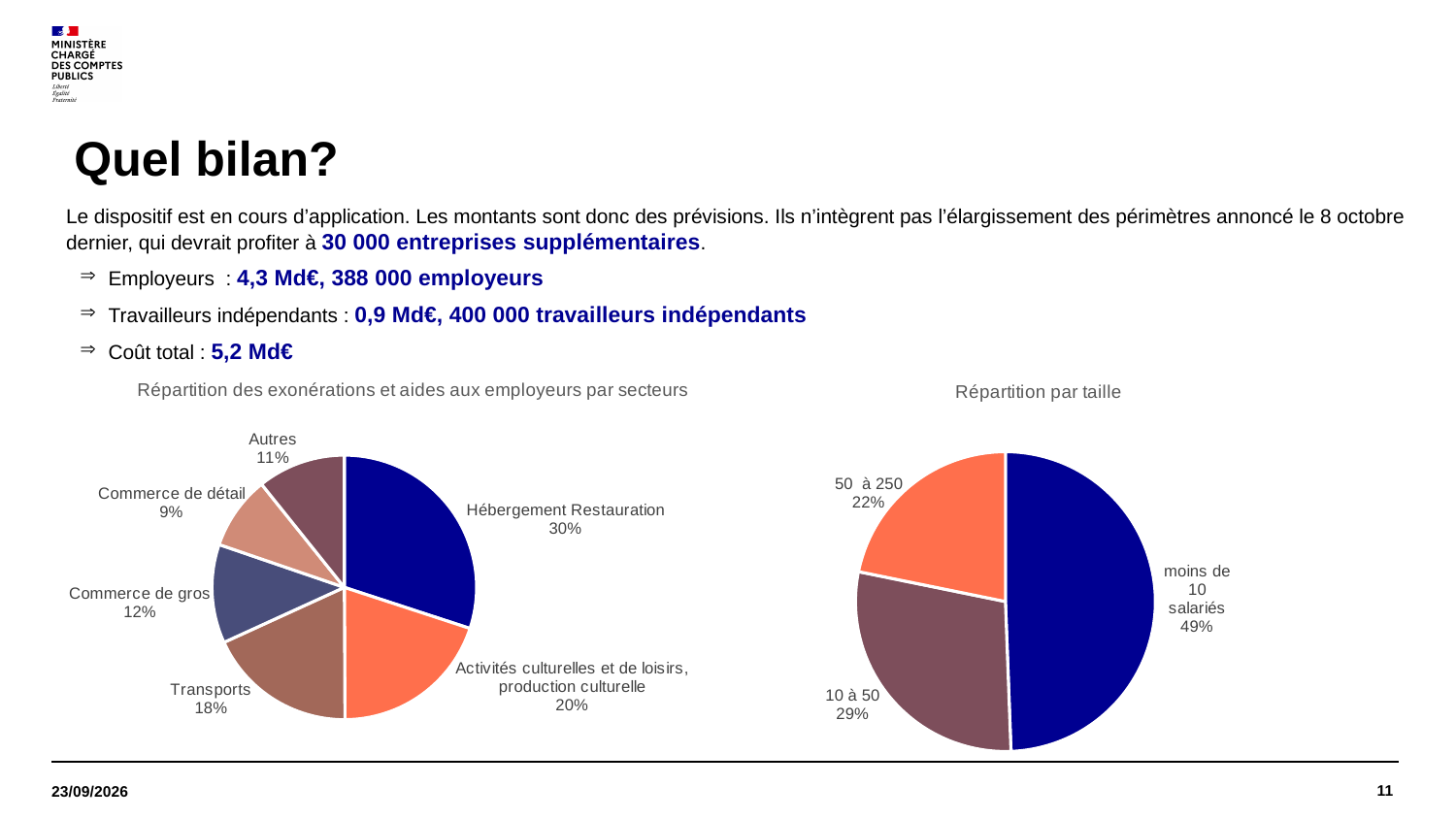
In the chart titled "Répartition des exonérations et aides aux employeurs par secteurs", which sector has the smallest share? Commerce de détail In the chart titled "Répartition par taille", what share do companies with moins de 10 salariés have? 49% In the chart titled "Répartition par taille", what is the difference between 10 à 50 and 50 à 250? 7% In the chart titled "Répartition des exonérations et aides aux employeurs par secteurs", which sector has the largest share? Hébergement Restauration In the chart titled "Répartition des exonérations et aides aux employeurs par secteurs", which is larger: Commerce de gros or Autres? Commerce de gros In the chart titled "Répartition des exonérations et aides aux employeurs par secteurs", how many sectors are shown? 6 What kind of chart is the chart titled "Répartition par taille"? Pie chart In the chart titled "Répartition des exonérations et aides aux employeurs par secteurs", what share does Hébergement Restauration have? 30% In the chart titled "Répartition des exonérations et aides aux employeurs par secteurs", what is the value for Transports? 18% In the chart titled "Répartition par taille", what is the value for 50 à 250? 22% In the chart titled "Répartition des exonérations et aides aux employeurs par secteurs", what is the difference between Hébergement Restauration and Commerce de gros? 18% In the chart titled "Répartition par taille", which category has the smallest share? 50 à 250